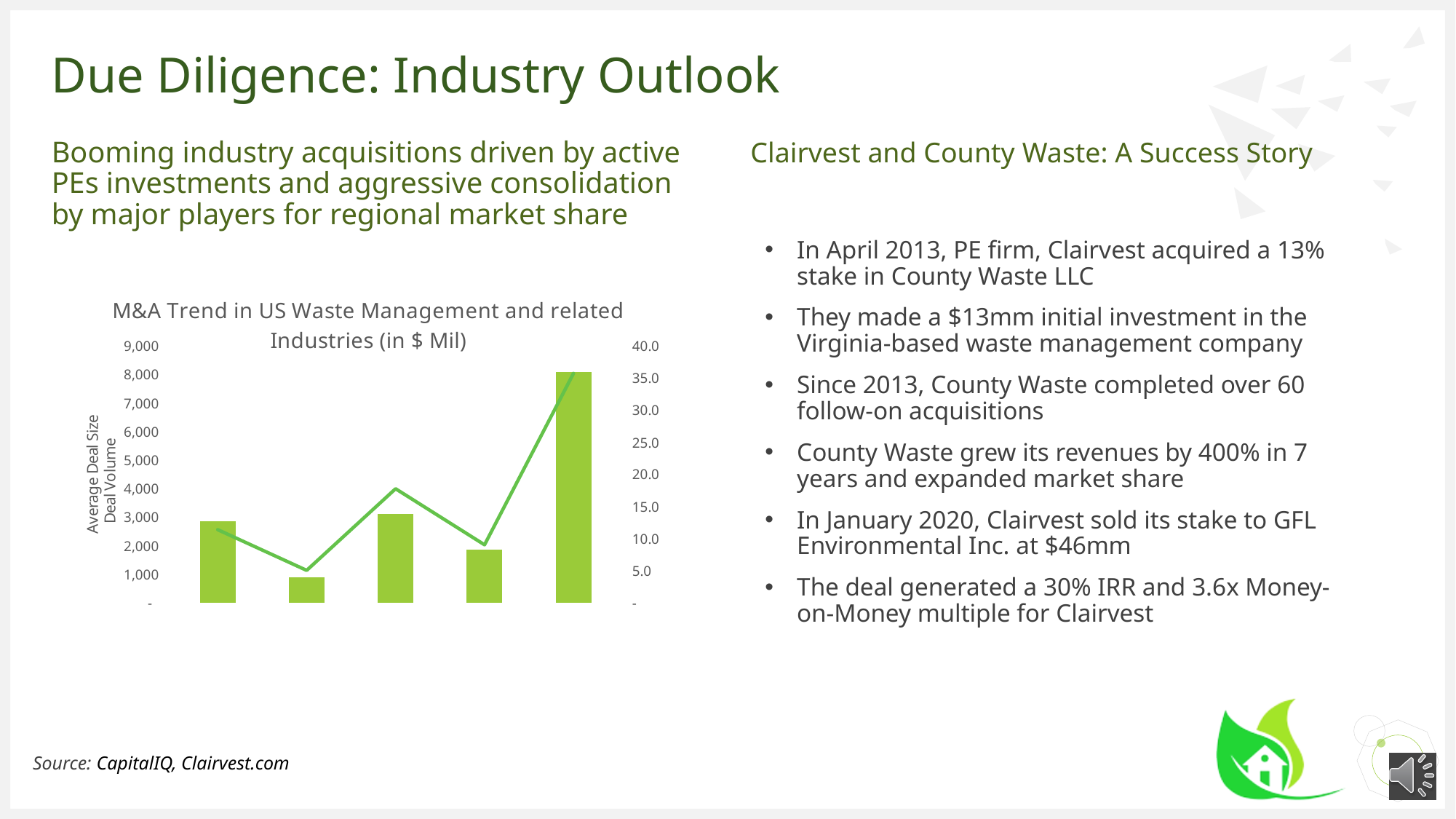
Which bar in the chart is the tallest? The fifth (rightmost) bar Which bar in the chart is the shortest? The second bar from the left What is the highest tick value shown on the right-hand axis of the chart? 40.0 Is the value of the rightmost bar greater or less than 7,000 on the left axis? greater Is the value of the second bar from the left greater or less than 2,000 on the left axis? less Is the last point of the line greater or less than 30.0 on the right axis? greater Is the rightmost bar higher or lower than the leftmost bar? higher Which is taller, the third bar or the fourth bar from the left? The third bar What kind of chart is shown on the slide? A combined bar and line chart What is the title of the chart on the slide? M&A Trend in US Waste Management and related Industries (in $ Mil) How many bars are plotted in the chart? 5